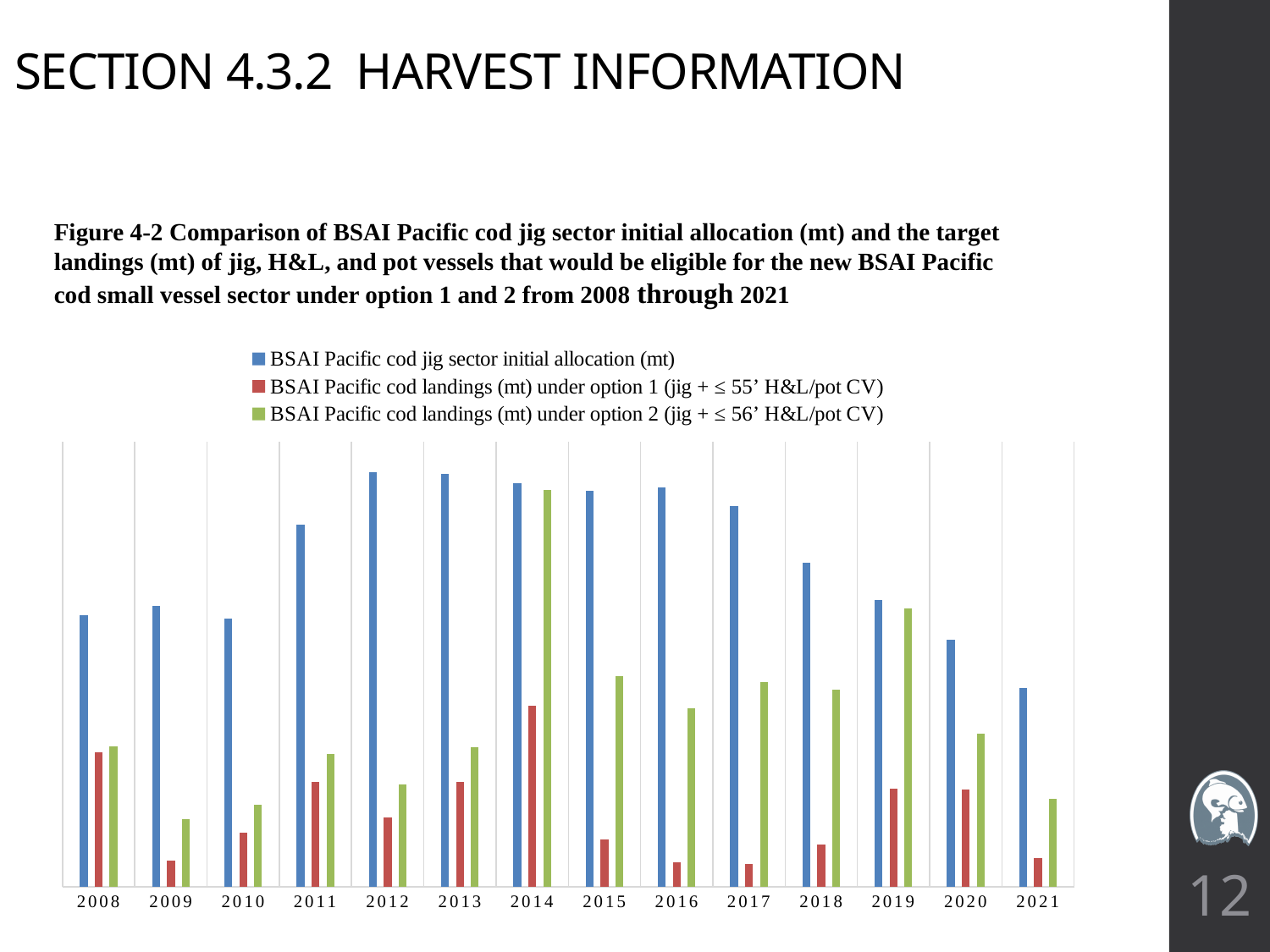
What is the first year shown on the chart's x axis? 2008 Which is larger: landings under option 2 in 2019 or in 2008? 2019 How many series does the chart's legend list? 3 In which year are the BSAI Pacific cod landings (mt) under option 2 highest? 2014 In 2021, which is larger: landings under option 1 or landings under option 2? option 2 Which is larger: the jig sector initial allocation in 2012 or in 2008? 2012 What kind of chart is shown on the slide? bar chart How many years are shown along the x axis of the chart? 14 In which year are the BSAI Pacific cod landings (mt) under option 1 highest? 2014 What colour represents the BSAI Pacific cod landings (mt) under option 2 in the chart? green In which year is the BSAI Pacific cod jig sector initial allocation (mt) lowest? 2021 Does the jig sector initial allocation rise or fall from 2016 to 2021? fall